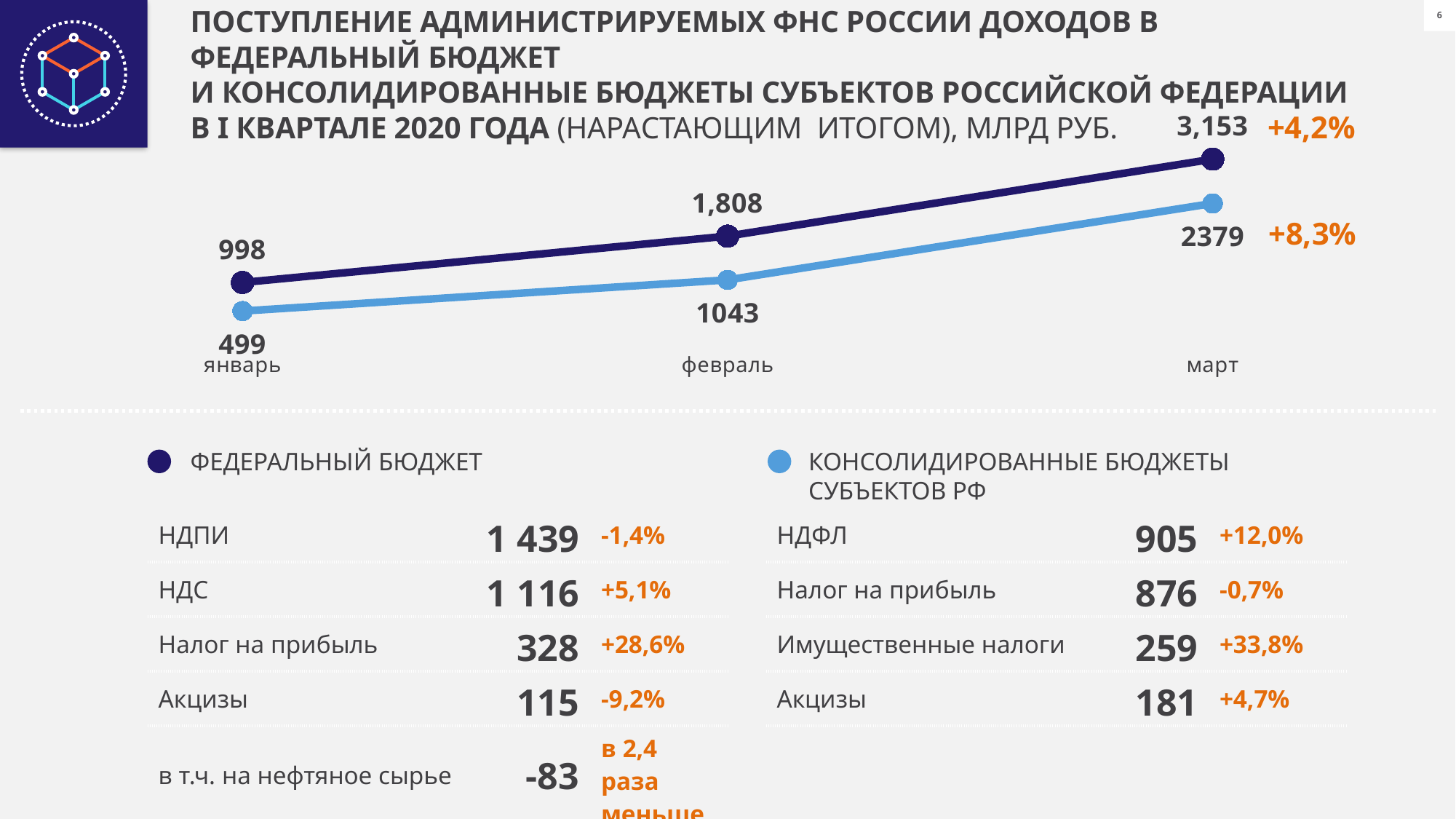
What is the value for Федеральный бюджет in февраль? 1,808 What is the value for Федеральный бюджет in январь? 998 In which month is the value for Консолидированные бюджеты субъектов РФ the highest? март What is the value for Консолидированные бюджеты субъектов РФ in январь? 499 What type of chart is shown on the slide? line chart What is the value for Федеральный бюджет in март? 3,153 Which series has the larger value in февраль, Федеральный бюджет or Консолидированные бюджеты субъектов РФ? Федеральный бюджет How many months are plotted along the x axis of the chart? 3 Do the values for Федеральный бюджет rise or fall from январь to март? rise What is the difference between the Федеральный бюджет and Консолидированные бюджеты субъектов РФ values in март? 774 How many series does the chart's legend list? 2 What is the value for Консолидированные бюджеты субъектов РФ in март? 2379